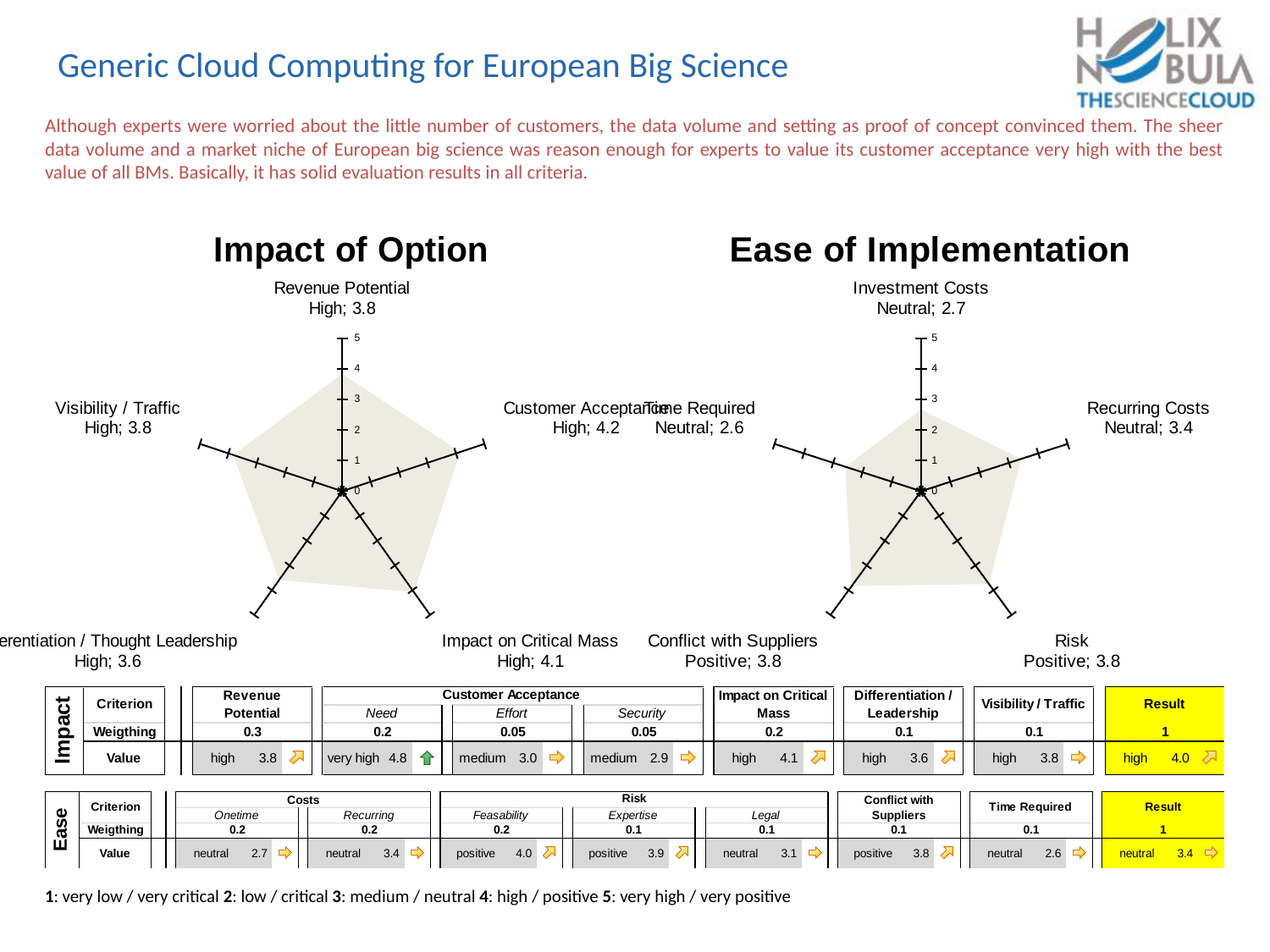
On the Ease of Implementation chart, what is the value for Investment Costs? 2.7 On the Ease of Implementation chart, which criterion has the lowest value? Time Required What is the maximum value shown on the axis scale of the Impact of Option chart? 5 How many criteria are plotted on the Impact of Option chart? 5 On the Impact of Option chart, what is the value for Revenue Potential? 3.8 What kind of chart is the Ease of Implementation chart? Radar chart On the Impact of Option chart, which criterion has the highest value? Customer Acceptance On the Ease of Implementation chart, which is larger, the value for Risk or the value for Time Required? Risk On the Impact of Option chart, what is the difference between the values for Customer Acceptance and Differentiation / Thought Leadership? 0.6 On the Impact of Option chart, what is the value for Customer Acceptance? 4.2 On the Ease of Implementation chart, is the value for Investment Costs greater or less than 3? less On the Ease of Implementation chart, what is the value for Recurring Costs? 3.4